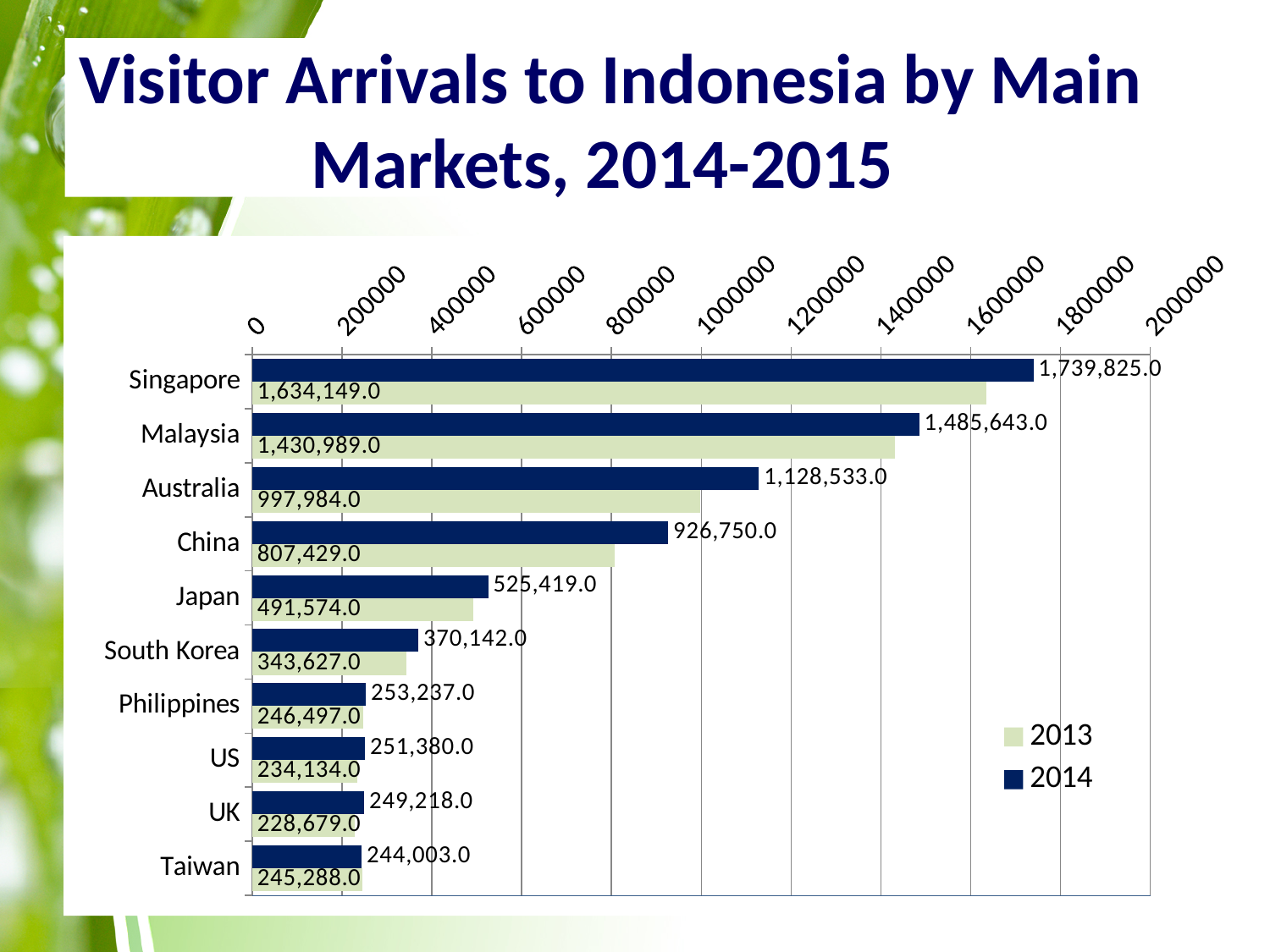
What is the difference between the 2014 and 2013 values for China? 119,321.0 Is the 2013 value for Malaysia greater or less than 1400000? greater For Taiwan, which is larger: the 2013 value or the 2014 value? 2013 What is the 2014 value for South Korea? 370,142.0 What kind of chart is shown on the slide? Bar chart Which series is shown in dark navy bars? 2014 Which country has the highest 2014 value? Singapore What is the 2014 value for Singapore? 1,739,825.0 How many countries are shown on the chart? 10 Which country has the lowest 2013 value? UK What is the 2013 value for Australia? 997,984.0 How many series does the legend list? 2